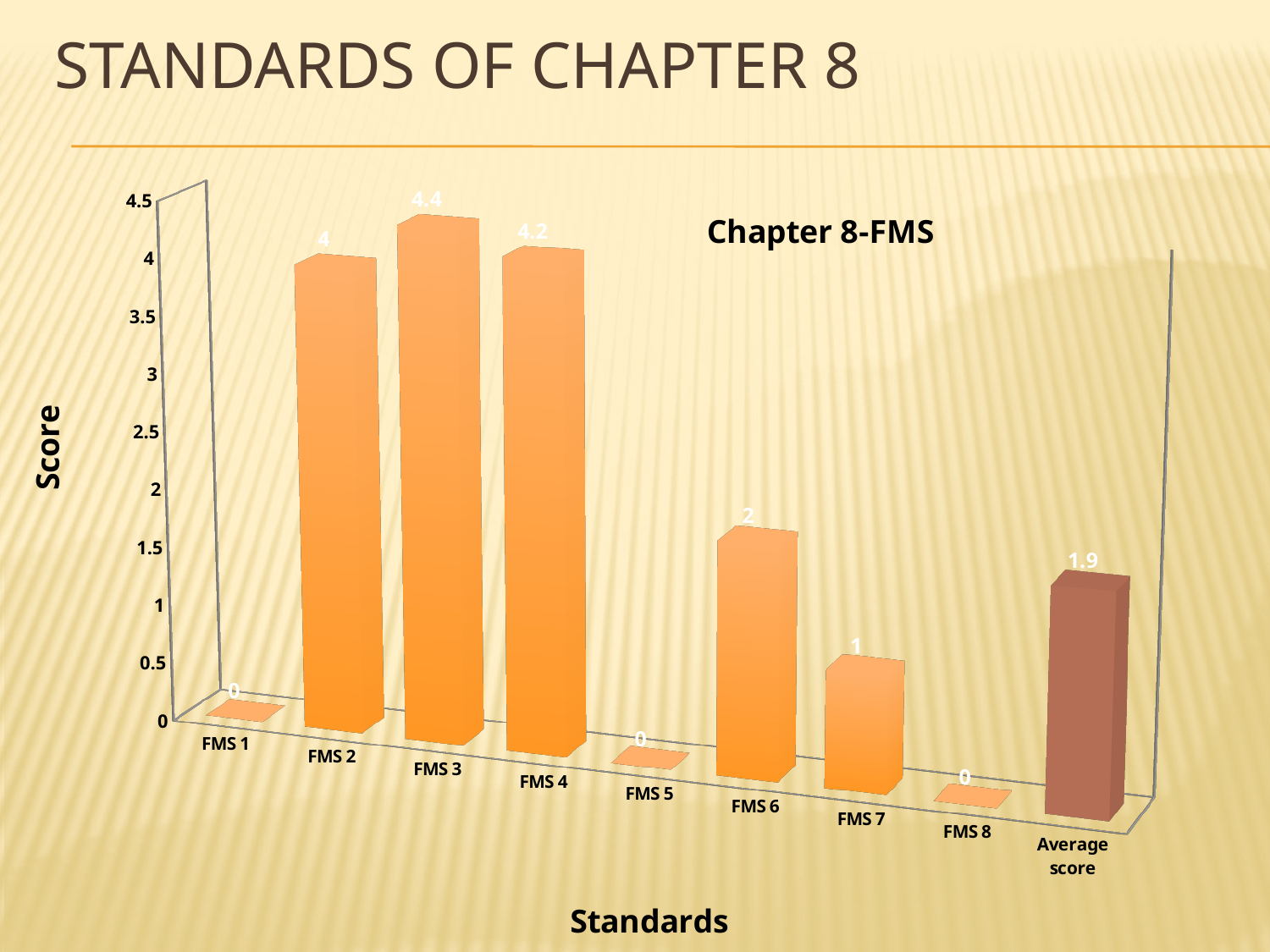
What is the score for FMS 6? 2 Which has a higher score, FMS 6 or FMS 7? FMS 6 What is the difference between the scores for FMS 3 and FMS 2? 0.4 What is the Average score shown on the chart? 1.9 What is the score for FMS 3? 4.4 What kind of chart is shown on the slide? Bar chart What is the difference between the scores for FMS 4 and FMS 7? 3.2 What is the title of the chart? Chapter 8-FMS How many standards have a score of 0? 3 How many categories are shown on the x axis? 9 Which has a higher score, FMS 2 or FMS 4? FMS 4 Which standard has the highest score? FMS 3